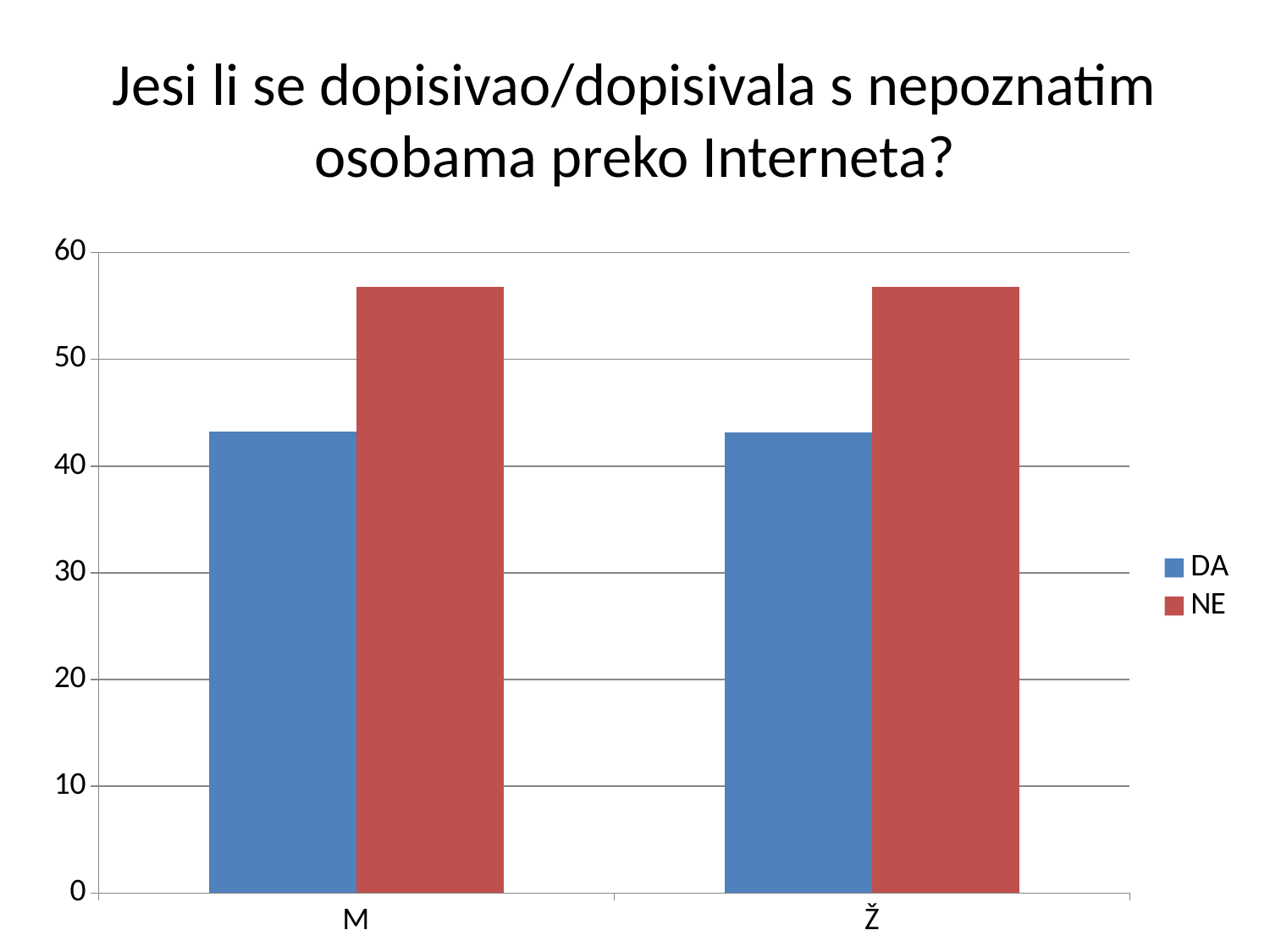
What kind of chart is shown on the slide? bar chart What is the title of the chart? Jesi li se dopisivao/dopisivala s nepoznatim osobama preko Interneta? Which series has the lowest bar in category M? DA Is the value for NE in category M greater or less than 50? greater For category M, which is larger, DA or NE? NE How many series does the legend list? 2 Which colour represents the NE series in the legend? red Is the value for NE in category Ž greater or less than 60? less How many categories are shown on the x axis? 2 Is the value for DA in category Ž greater or less than 50? less For category Ž, which series has the higher bar? NE